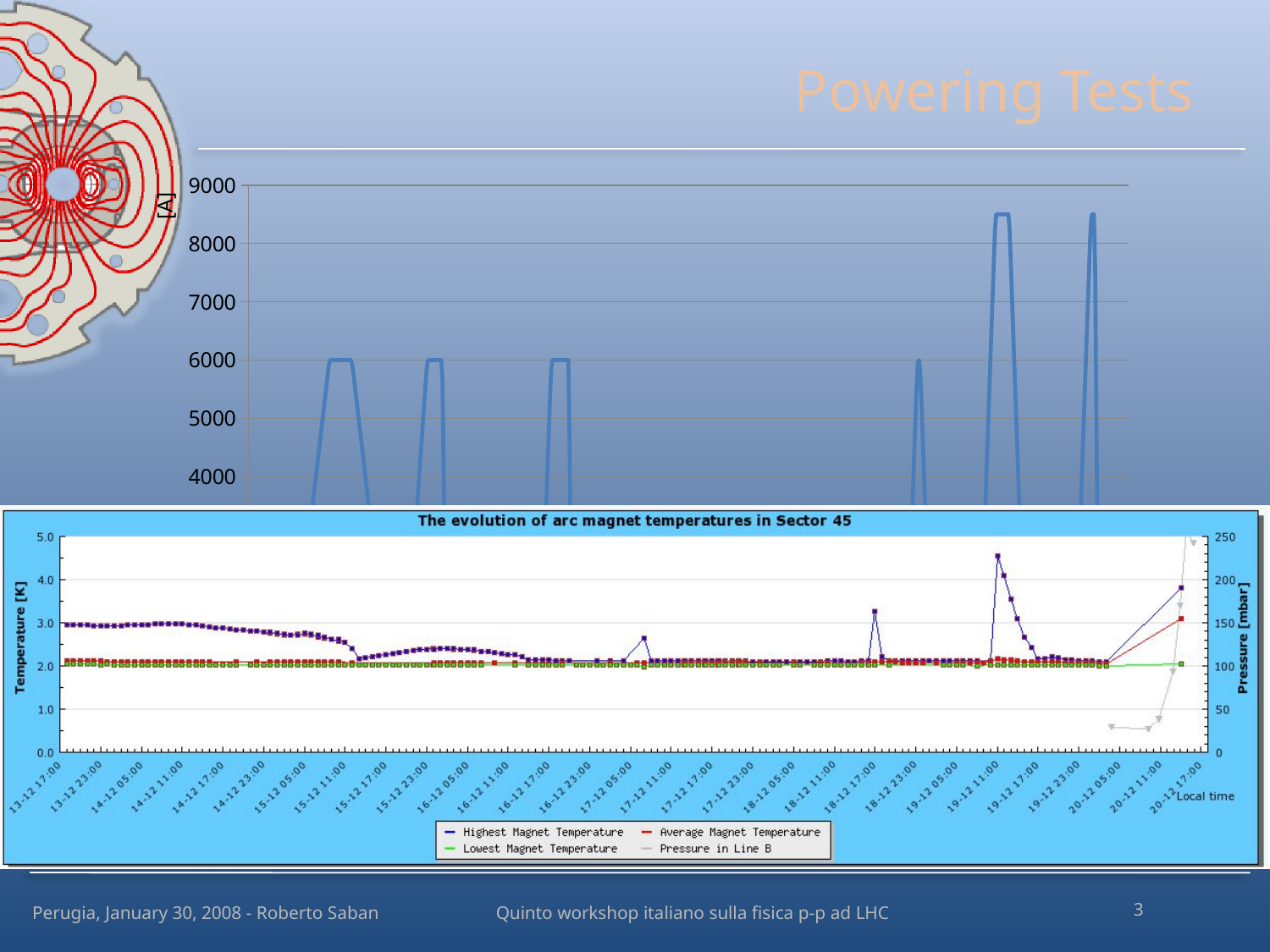
In the top chart, how many pulses (peaks) are plotted? 6 In the top chart, is the value of the first plateau greater or less than 7000? less What is the title of the bottom chart? The evolution of arc magnet temperatures in Sector 45 In the top chart, what value does the first plateau reach on the vertical axis? 6000 In the bottom chart, at the start of the period (13-12 17:00), which series has the highest temperature? Highest Magnet Temperature In the top chart, what is the unit shown on the vertical axis? [A] In the bottom chart, is the Lowest Magnet Temperature ever greater or less than 3.0? less In the bottom chart, is the peak value of Highest Magnet Temperature greater or less than 4.0? greater How many series does the legend of the bottom chart list? 4 In the bottom chart, does the Highest Magnet Temperature rise or fall between 13-12 17:00 and 16-12 11:00? fall What type of chart is the top chart on the slide? line chart